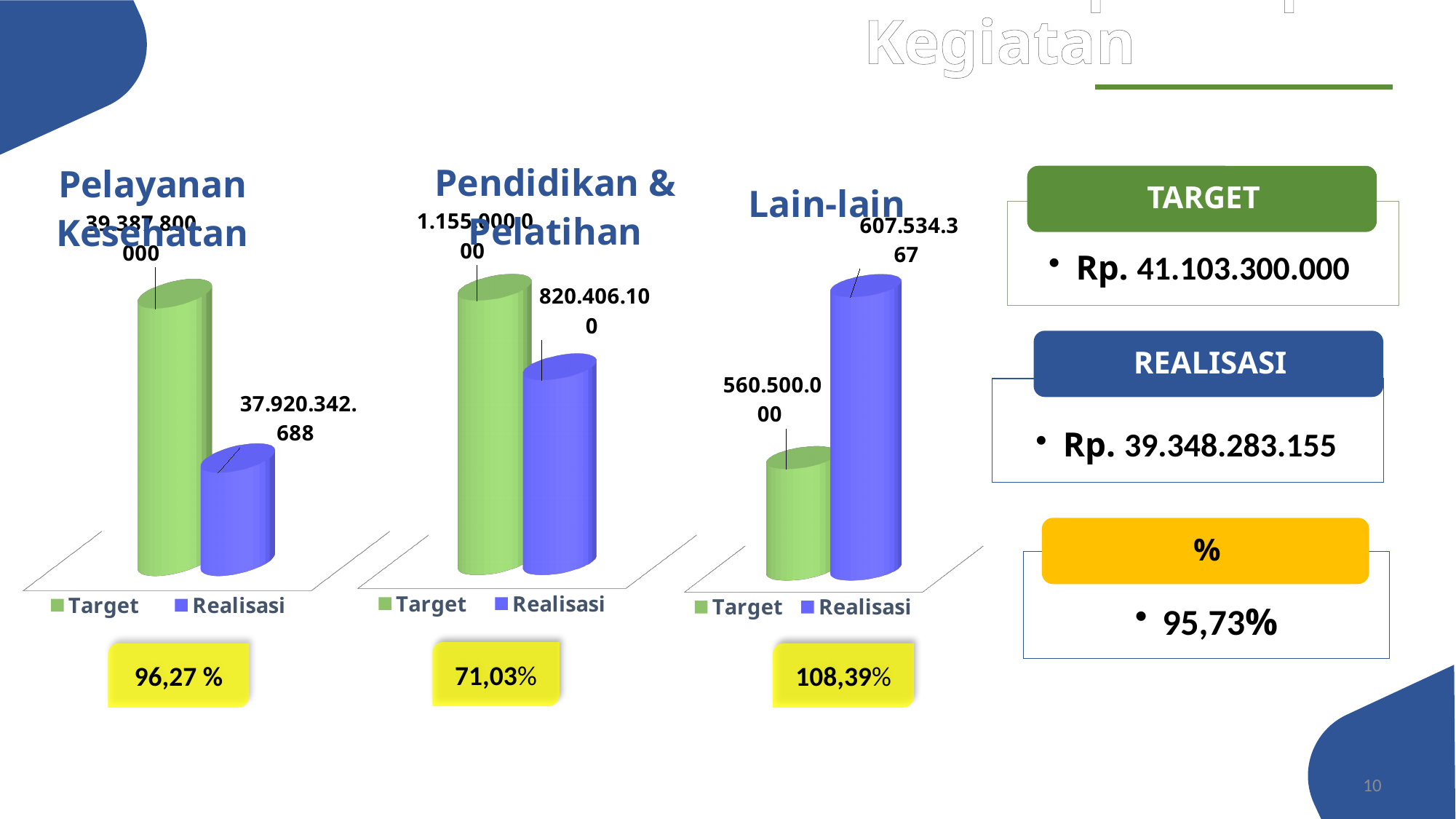
In the Lain-lain chart, what is the value of Target? 560.500.000 In the Lain-lain chart, which is larger, Target or Realisasi? Realisasi In the Pelayanan Kesehatan chart, which is larger, Target or Realisasi? Target What colour are the Realisasi bars in the three charts? Blue In the Lain-lain chart, what is the difference between Realisasi and Target? 47.034.367 How many series does the legend of the Pelayanan Kesehatan chart list? 2 In the Lain-lain chart, what is the value of Realisasi? 607.534.367 In the Pendidikan & Pelatihan chart, which is larger, Target or Realisasi? Target In the Pelayanan Kesehatan chart, what is the value of Realisasi? 37.920.342.688 In the Pendidikan & Pelatihan chart, what is the value of Realisasi? 820.406.100 What kind of chart is the Lain-lain chart? Bar chart What percentage is shown below the Pendidikan & Pelatihan chart? 71,03%